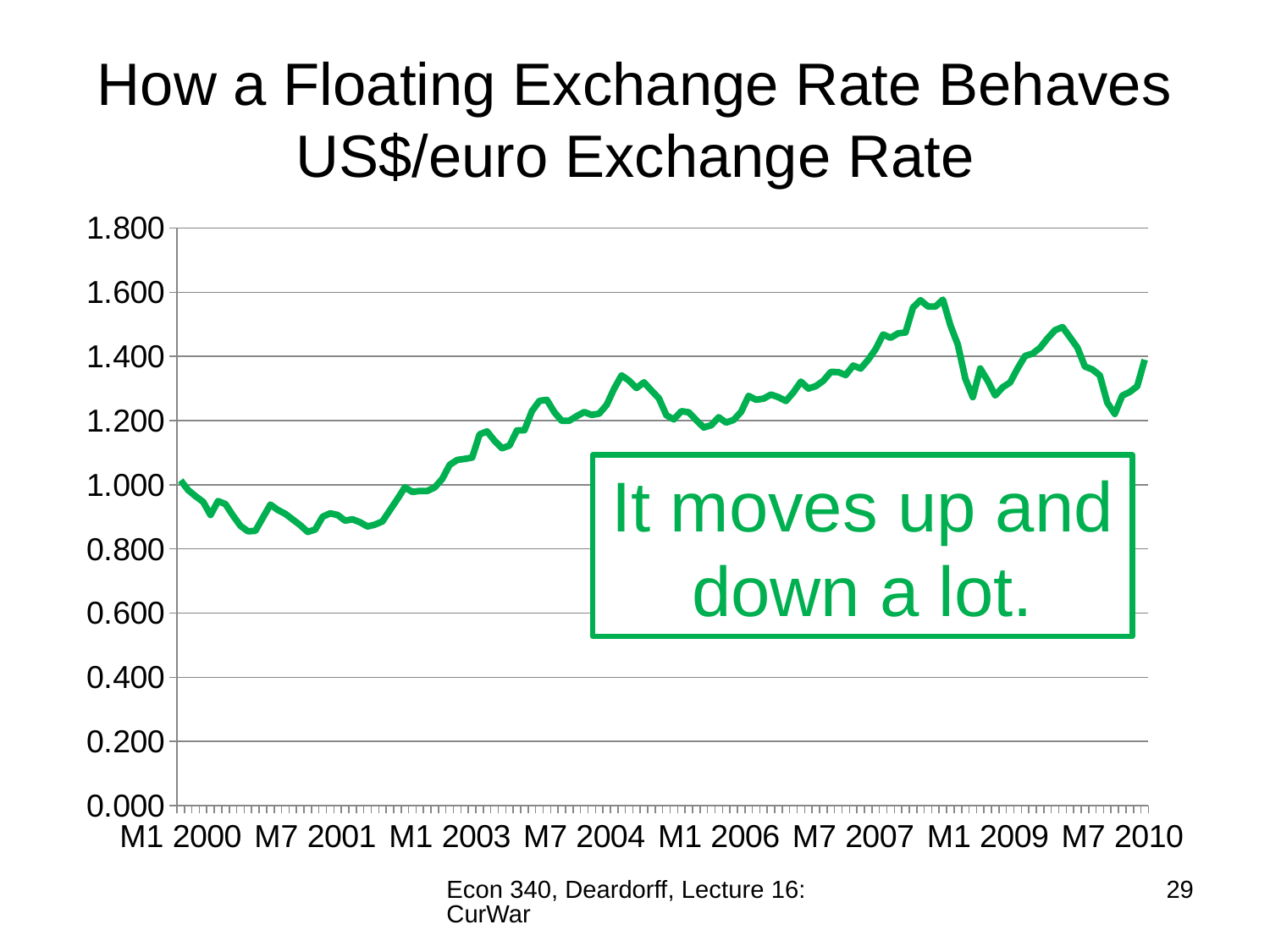
Is the US$/euro exchange rate at M1 2000 greater or less than 0.800? greater What is the highest value shown on the y axis? 1.800 Is the US$/euro exchange rate at M7 2001 greater or less than 1.000? less Is the US$/euro exchange rate at M7 2007 greater or less than 1.200? greater Does the exchange rate rise or fall between M1 2000 and M7 2001? fall Does the exchange rate generally rise or fall between M7 2001 and M7 2007? rise Is the exchange rate higher at M7 2007 or at M7 2001? M7 2007 What does the green text box on the chart say? It moves up and down a lot. What kind of chart is shown on the slide? line chart